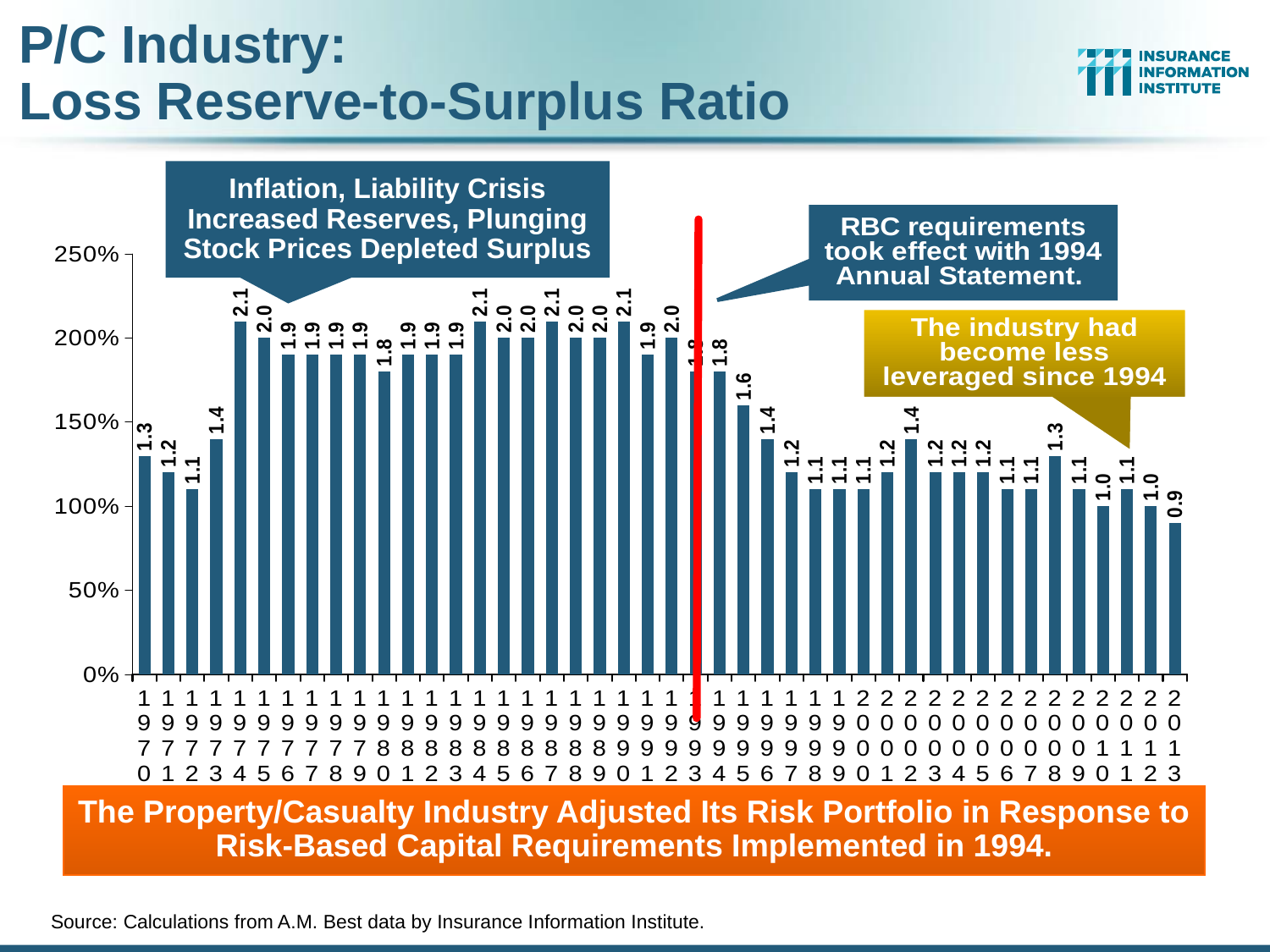
What value is labeled on the bar for 1995? 1.6 Is the value for 1990 greater or less than 200%? greater What is the difference between the labeled values for 1974 and 1973? 0.7 What is the highest labeled value on the chart? 2.1 How many years (bars) are shown on the chart? 44 According to the callout, in what year did RBC requirements take effect with the Annual Statement? 1994 What value is labeled on the bar for 2013? 0.9 Which year has the lowest loss reserve-to-surplus ratio? 2013 Do the values generally rise or fall from 1994 to 2013? Fall Which year has the larger value, 1994 or 2002? 1994 What kind of chart is shown on the slide? Bar chart What is the loss reserve-to-surplus ratio value labeled for 1970? 1.3